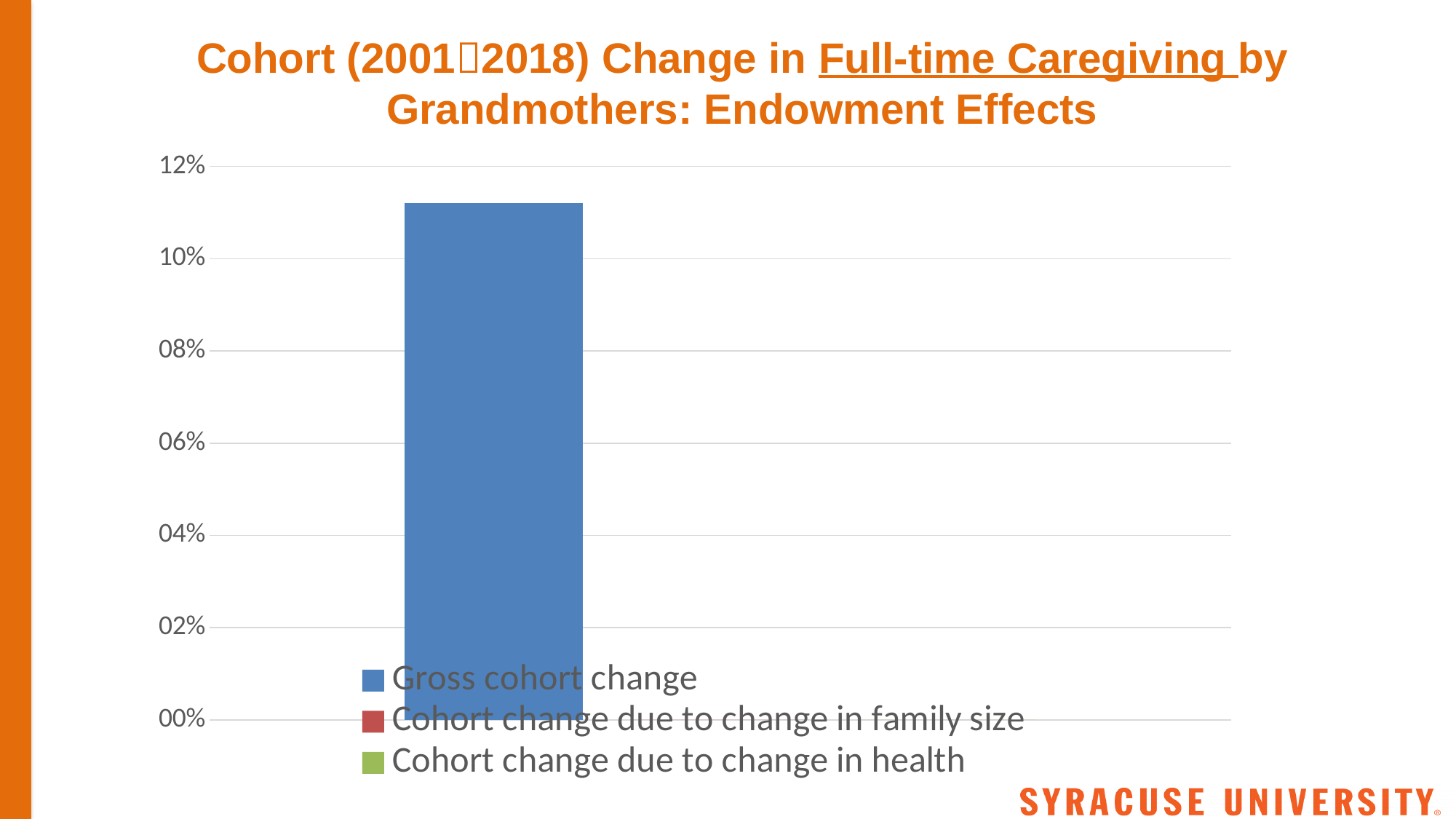
Is the value for Gross cohort change greater or less than 12%? less How many series does the legend list? 3 How many bars are plotted on the chart? 1 What colour is the legend marker for Gross cohort change? blue Is the value for Gross cohort change greater or less than 10%? greater What kind of chart is shown on the slide? bar chart Is the value for Gross cohort change greater or less than 8%? greater What is the highest value shown on the vertical axis? 12% Which series is plotted with the visible bar on the chart? Gross cohort change